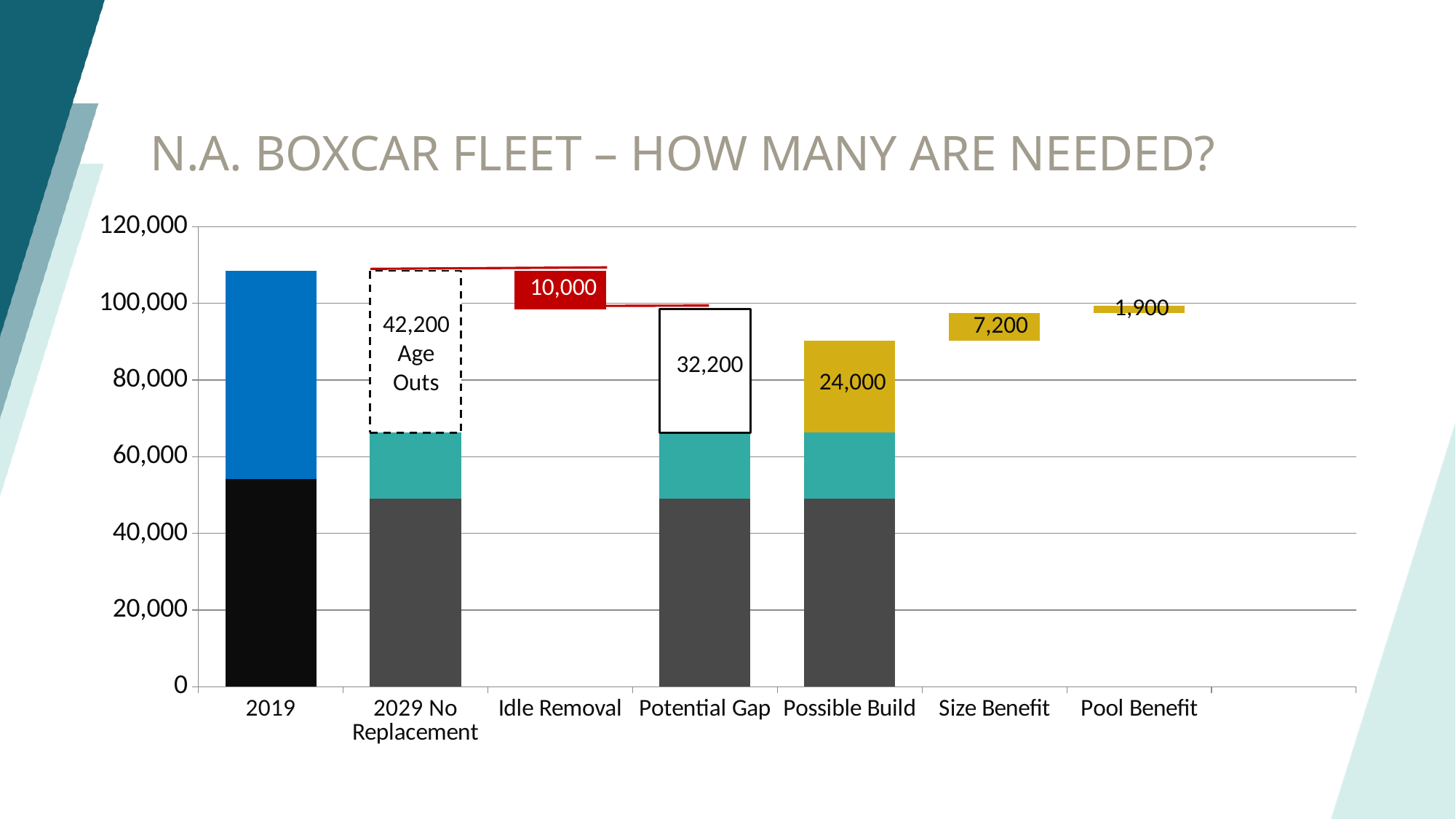
What is the difference between the Potential Gap value (32,200) and the Possible Build value (24,000)? 8,200 Which is larger, the Size Benefit value or the Pool Benefit value? Size Benefit What value is labelled on the Idle Removal bar? 10,000 What is the title of the chart? N.A. BOXCAR FLEET – HOW MANY ARE NEEDED? How many Age Outs are labelled in the dashed box of the 2029 No Replacement bar? 42,200 What value is labelled for Size Benefit? 7,200 What value is labelled in the Potential Gap box? 32,200 What value is labelled for Pool Benefit? 1,900 How many categories are shown on the x axis of the chart? 7 What value is labelled on the gold segment of the Possible Build bar? 24,000 Is the total height of the 2019 bar greater or less than 100,000? greater What kind of chart is shown on the slide? bar chart